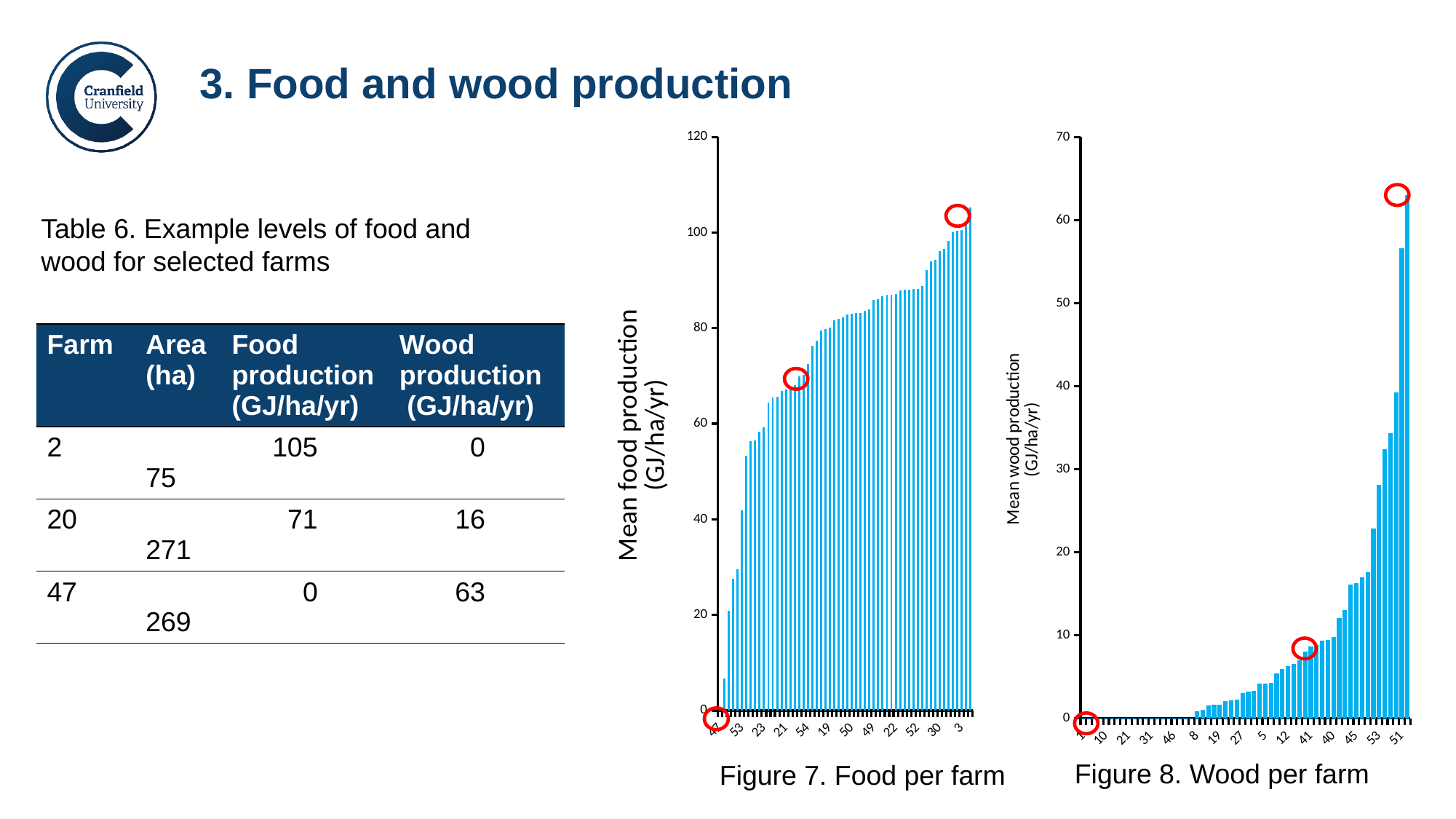
What kind of chart is Figure 7. Food per farm? bar chart In Figure 8. Wood per farm, is the value of the bar for farm 10 greater or less than 10? less What is the highest value shown on the y axis of Figure 7. Food per farm? 120 In Figure 8. Wood per farm, do the bar values rise or fall from left to right along the x axis? rise In Figure 8. Wood per farm, is the value of the tallest bar greater or less than 60? greater In Figure 7. Food per farm, is the value of the tallest bar greater or less than 100? greater What kind of chart is Figure 8. Wood per farm? bar chart Which chart has the taller maximum bar, Figure 7. Food per farm or Figure 8. Wood per farm? Figure 7. Food per farm What is the y-axis title of Figure 8. Wood per farm? Mean wood production (GJ/ha/yr) In Figure 7. Food per farm, do the bar values rise or fall from left to right along the x axis? rise